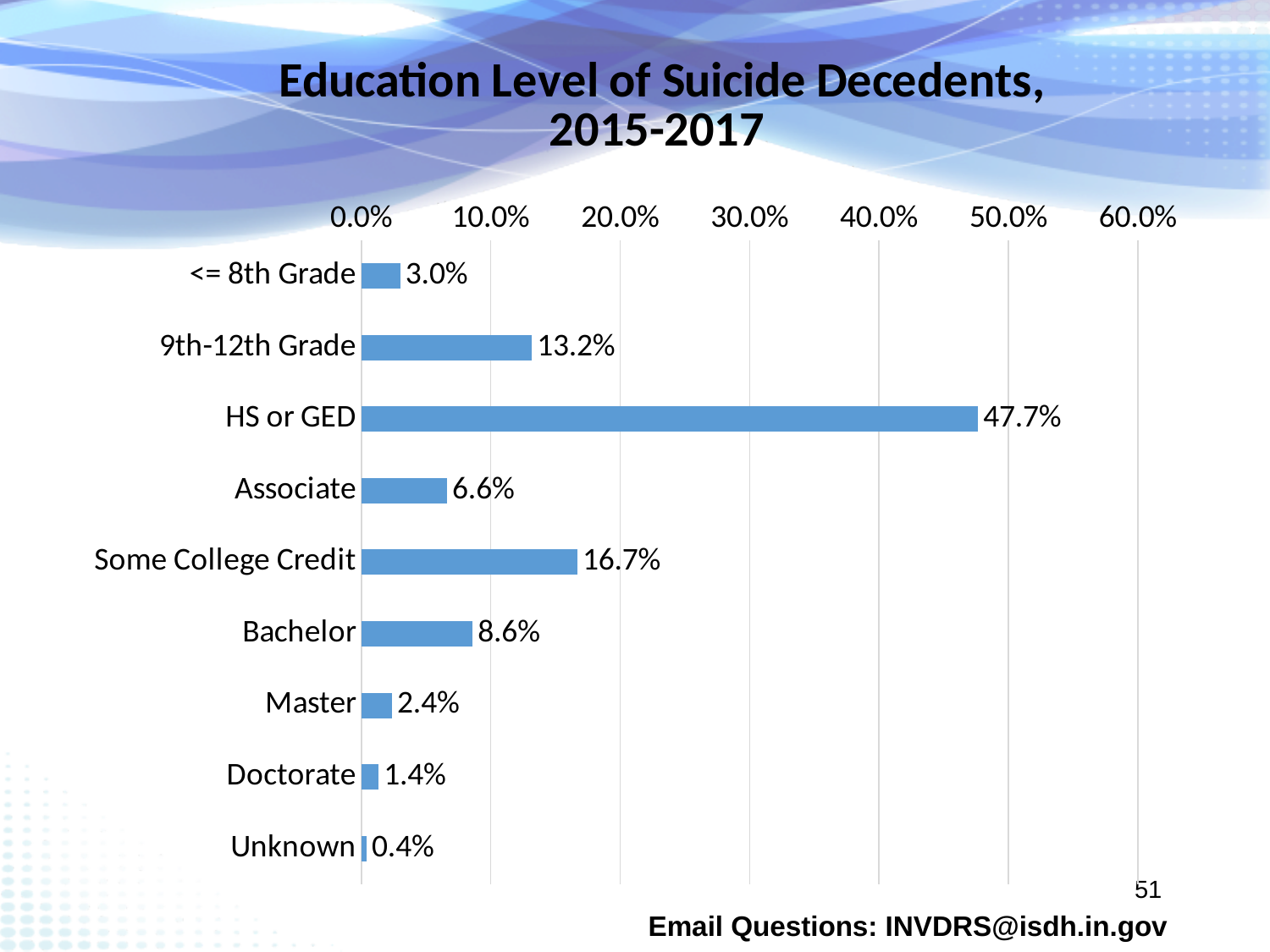
What is the value for Some College Credit? 16.7% Which education level has the highest value? HS or GED Which education level has the lowest value? Unknown What is the value for HS or GED? 47.7% Is the value for Some College Credit greater or less than 20.0%? less How many education level categories are shown in the chart? 9 Which is larger, the value for Bachelor or the value for Associate? Bachelor What is the value for Doctorate? 1.4% What is the difference between the values for Master and Doctorate? 1.0% What is the title of the chart? Education Level of Suicide Decedents, 2015-2017 What is the difference between the values for 9th-12th Grade and <= 8th Grade? 10.2% What kind of chart is shown on the slide? bar chart